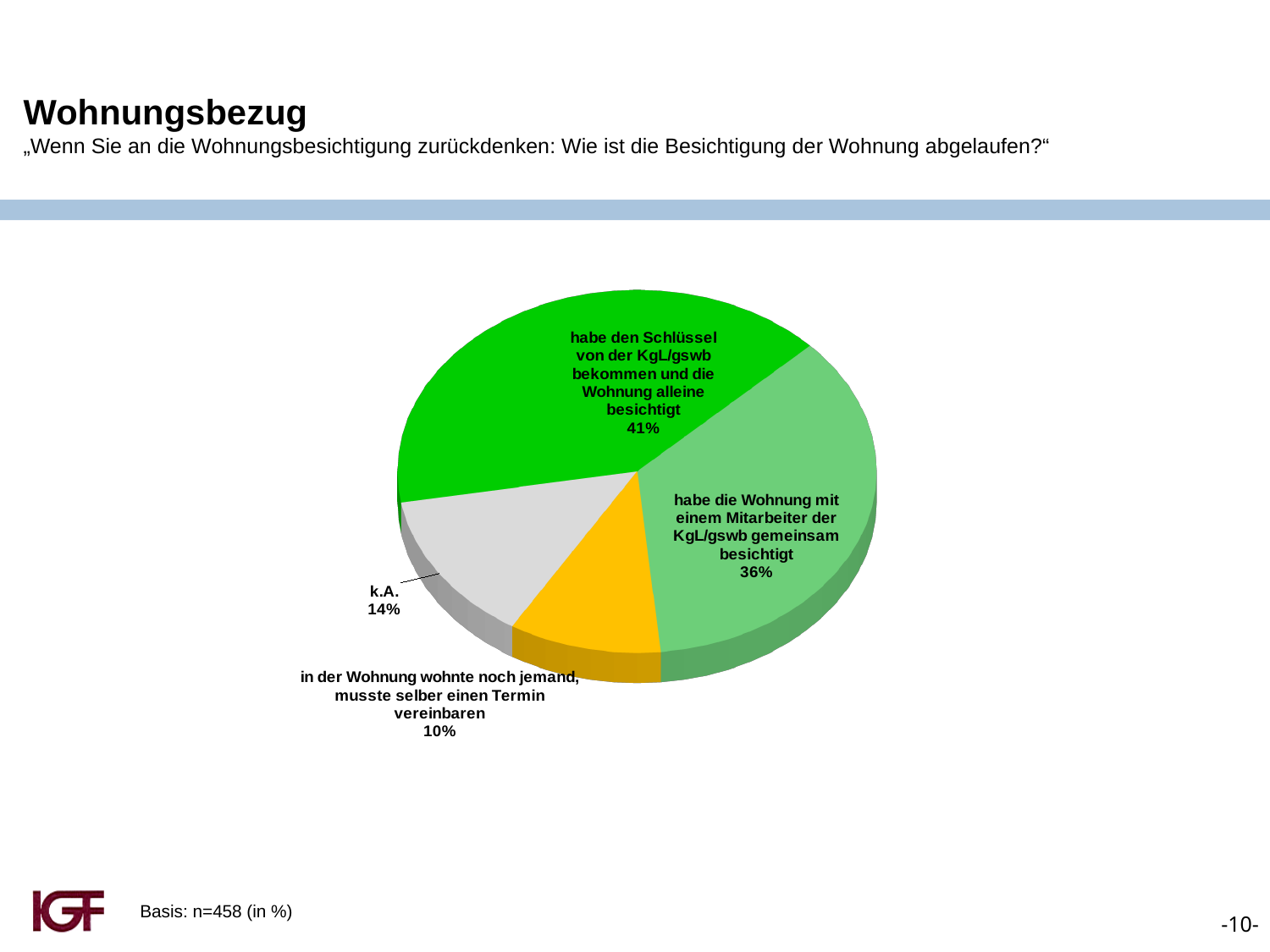
How many slices does the pie chart have? 4 What percentage of respondents said someone still lived in the apartment and they had to arrange an appointment themselves? 10% What is the sample size (Basis) stated on the slide? n=458 What is the combined share of 'k.A.' and 'in der Wohnung wohnte noch jemand, musste selber einen Termin vereinbaren'? 24% Which category has the smallest share of the pie? in der Wohnung wohnte noch jemand, musste selber einen Termin vereinbaren What percentage of respondents said they received the key from KgL/gswb and viewed the apartment alone? 41% What is the difference in percentage points between viewing the apartment alone (41%) and viewing it with a KgL/gswb employee (36%)? 5 Which is larger: the share for 'k.A.' or the share for 'in der Wohnung wohnte noch jemand, musste selber einen Termin vereinbaren'? k.A. What percentage of respondents viewed the apartment together with a KgL/gswb employee? 36% What kind of chart is shown on the slide? pie chart Which category has the largest share of the pie? habe den Schlüssel von der KgL/gswb bekommen und die Wohnung alleine besichtigt What share is labelled 'k.A.'? 14%